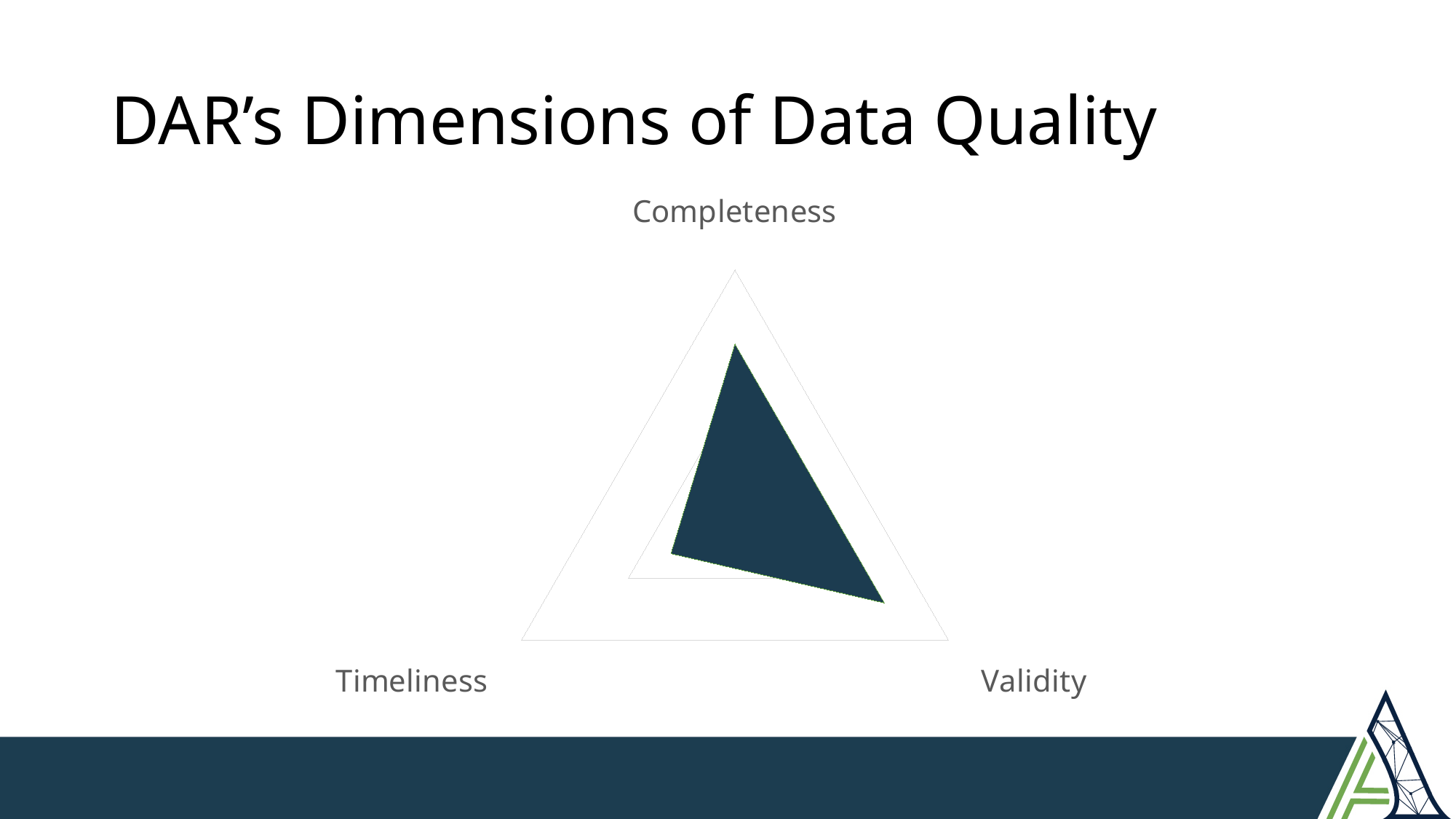
Which dimension has the lowest value on the radar chart? Timeliness How many dimensions (axes) does the radar chart plot? 3 Which has the larger value, Completeness or Timeliness? Completeness What are the three axis labels on the radar chart? Completeness, Timeliness, Validity What kind of chart is shown on the slide? Radar chart What is the title of the slide containing the radar chart? DAR's Dimensions of Data Quality